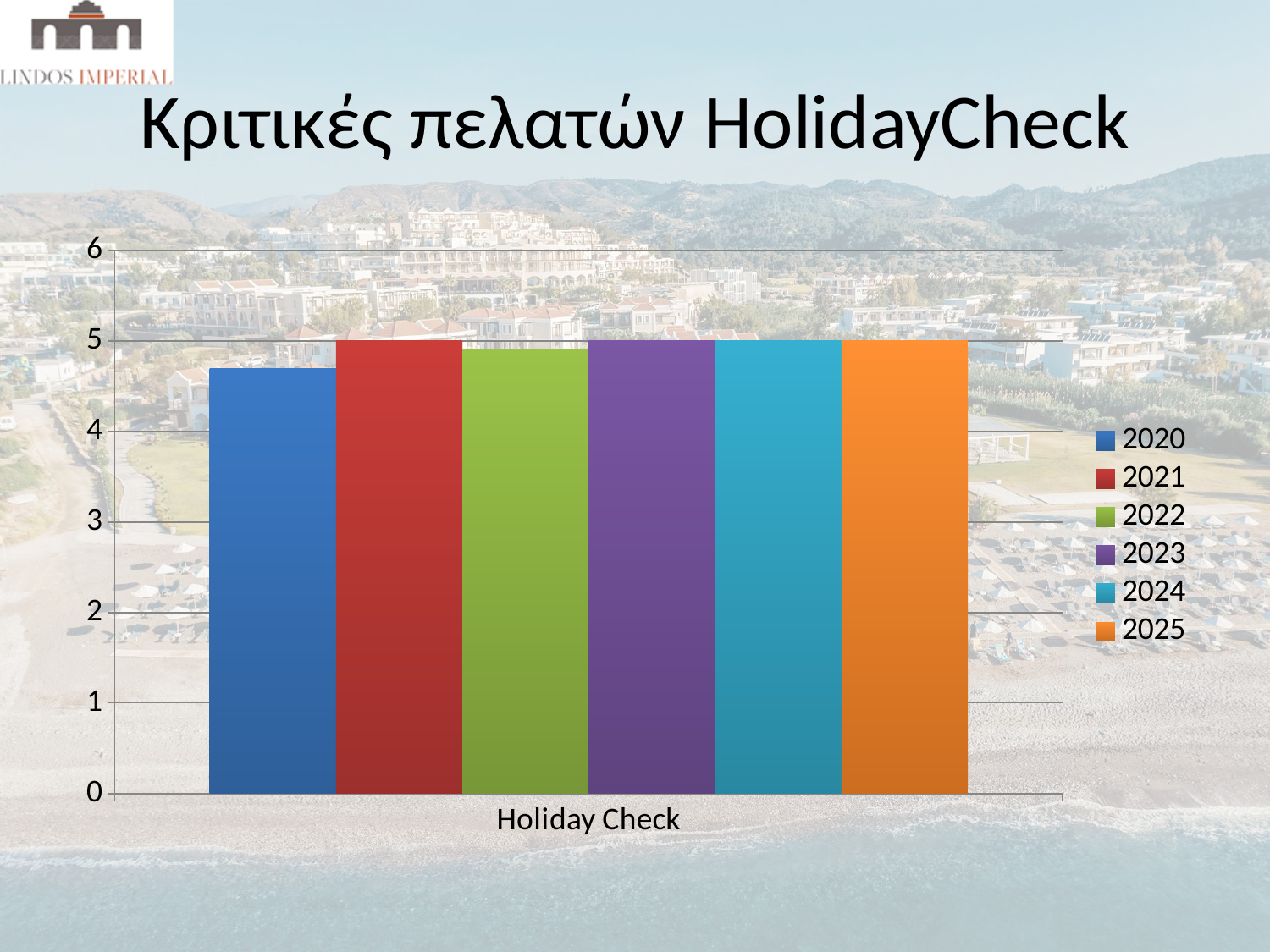
Is the value for 2020 greater or less than 4? greater Which is larger, the value for 2020 or the value for 2022? 2022 What kind of chart is shown on the slide? bar chart How many categories are shown on the x axis? 1 Is the value for 2022 greater or less than 4? greater What is the title of the slide containing the chart? Κριτικές πελατών HolidayCheck Is the value for 2020 greater or less than 5? less Which year has the lowest bar? 2020 How many series does the legend list? 6 Which is larger, the value for 2020 or the value for 2021? 2021 What is the category label shown on the x axis? Holiday Check